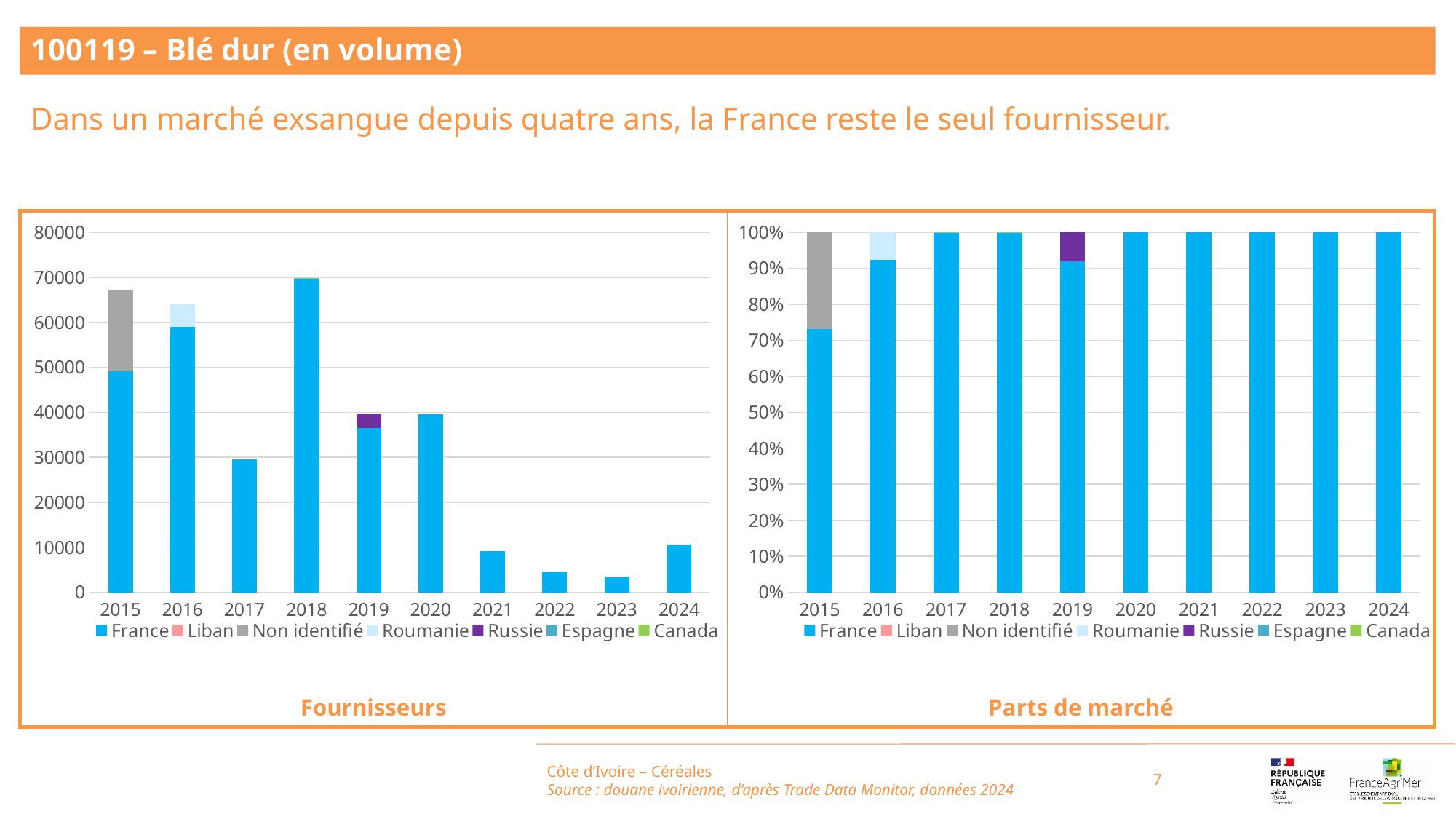
In the 'Fournisseurs' chart, which year has the lowest total volume? 2023 In the 'Fournisseurs' chart, do the total volumes rise or fall from 2020 to 2023? fall In the 'Fournisseurs' chart, is the total volume for 2017 greater or less than 20000? greater In the 'Fournisseurs' chart, which year has the larger total volume, 2017 or 2020? 2020 In the 'Fournisseurs' chart, is the total volume for 2021 greater or less than 10000? less How many years are shown on the x axis of the 'Parts de marché' chart? 10 How many series does the legend of the 'Fournisseurs' chart list? 7 In the 'Parts de marché' chart, is France's share in 2015 greater or less than 70%? greater What kind of chart is the 'Fournisseurs' chart on the left? bar chart In the 'Parts de marché' chart, which series is shown in grey? Non identifié In the 'Fournisseurs' chart, which year has the highest total volume? 2018